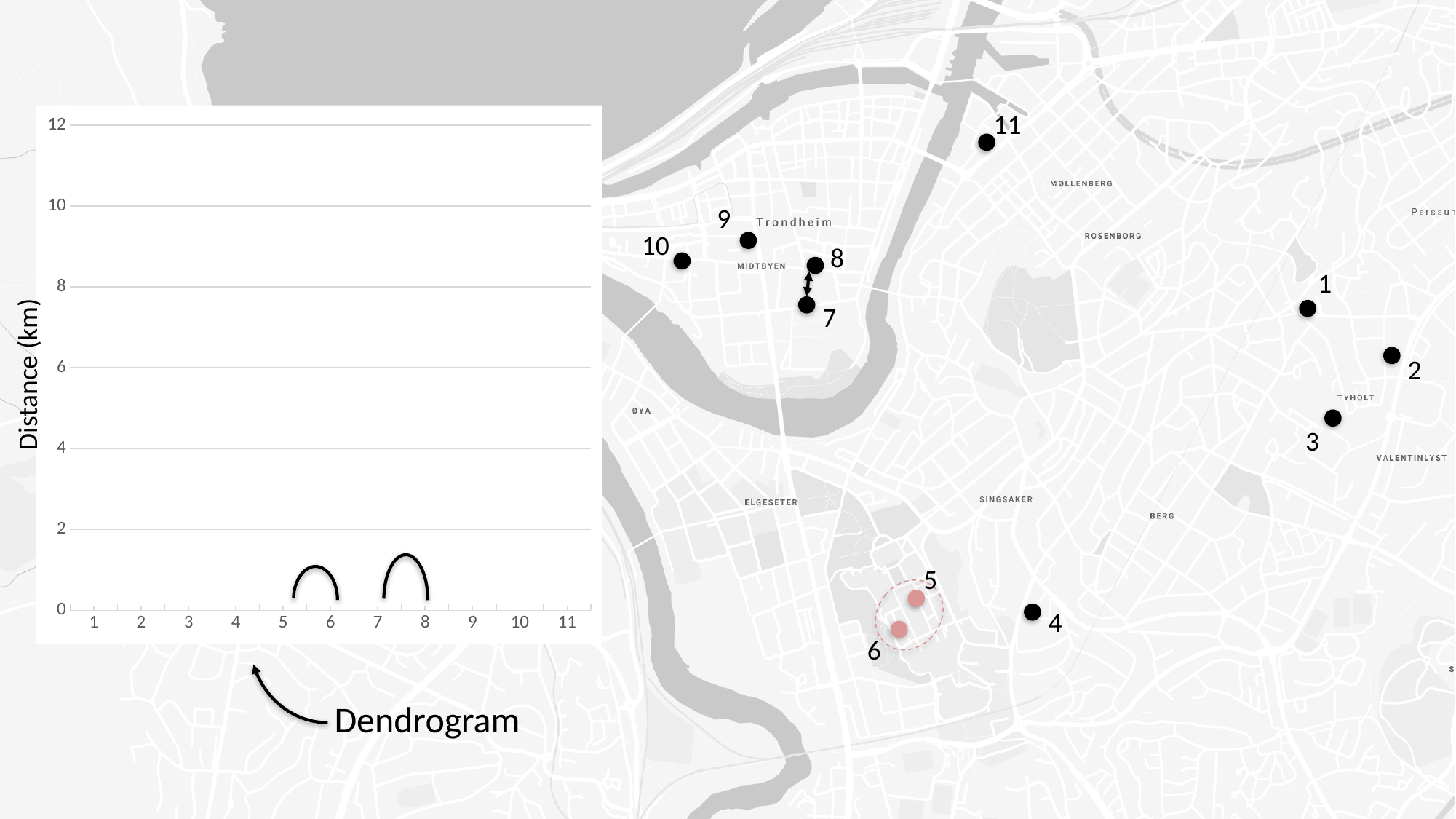
How many numbered points are listed along the x axis of the dendrogram? 11 What kind of chart is shown on the left of the slide? Dendrogram Is the merge distance for points 5 and 6 in the dendrogram greater or less than 2 km? less In the dendrogram, which merge is at a greater distance: the one joining 5 and 6 or the one joining 7 and 8? 7 and 8 How many merge arcs are drawn in the dendrogram? 2 Is the merge distance for points 7 and 8 in the dendrogram greater or less than 2 km? less Which two points does the left arc in the dendrogram connect? 5 and 6 What is the lowest value shown on the vertical axis of the dendrogram? 0 What is the highest value shown on the vertical axis of the dendrogram? 12 What is the label of the vertical axis of the dendrogram? Distance (km)